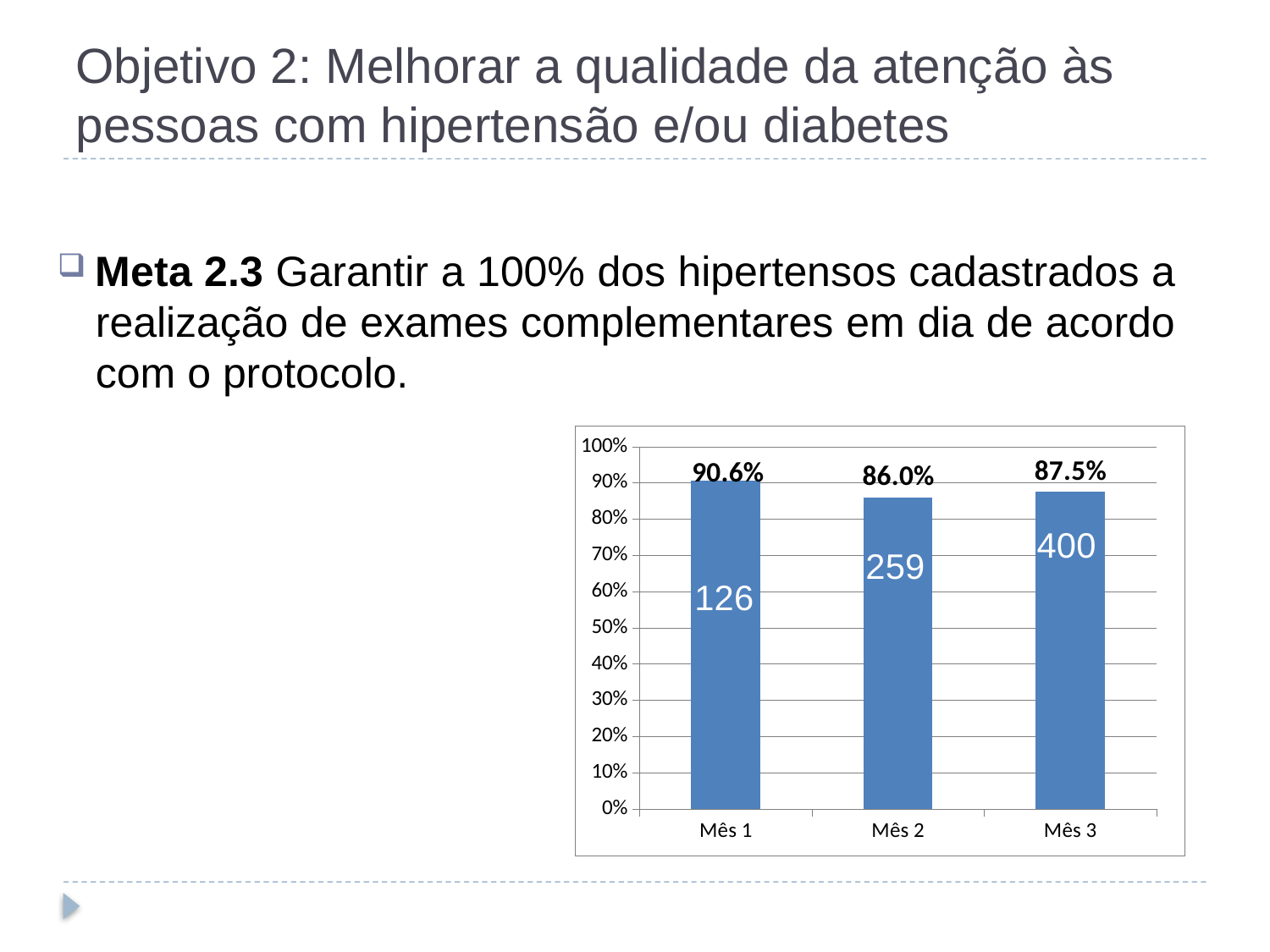
Which month has the highest percentage? Mês 1 What percentage is shown for Mês 2? 86.0% What number is printed inside the bar for Mês 1? 126 What is the difference in percentage points between Mês 1 and Mês 2? 4.6 Is the value for Mês 2 greater or less than 90%? less How many months are shown on the x axis? 3 What number is printed inside the bar for Mês 3? 400 What percentage is shown for Mês 1? 90.6% Which is larger, the percentage for Mês 3 or for Mês 2? Mês 3 What kind of chart is shown on the slide? bar chart Which month has the lowest percentage? Mês 2 What percentage is shown for Mês 3? 87.5%